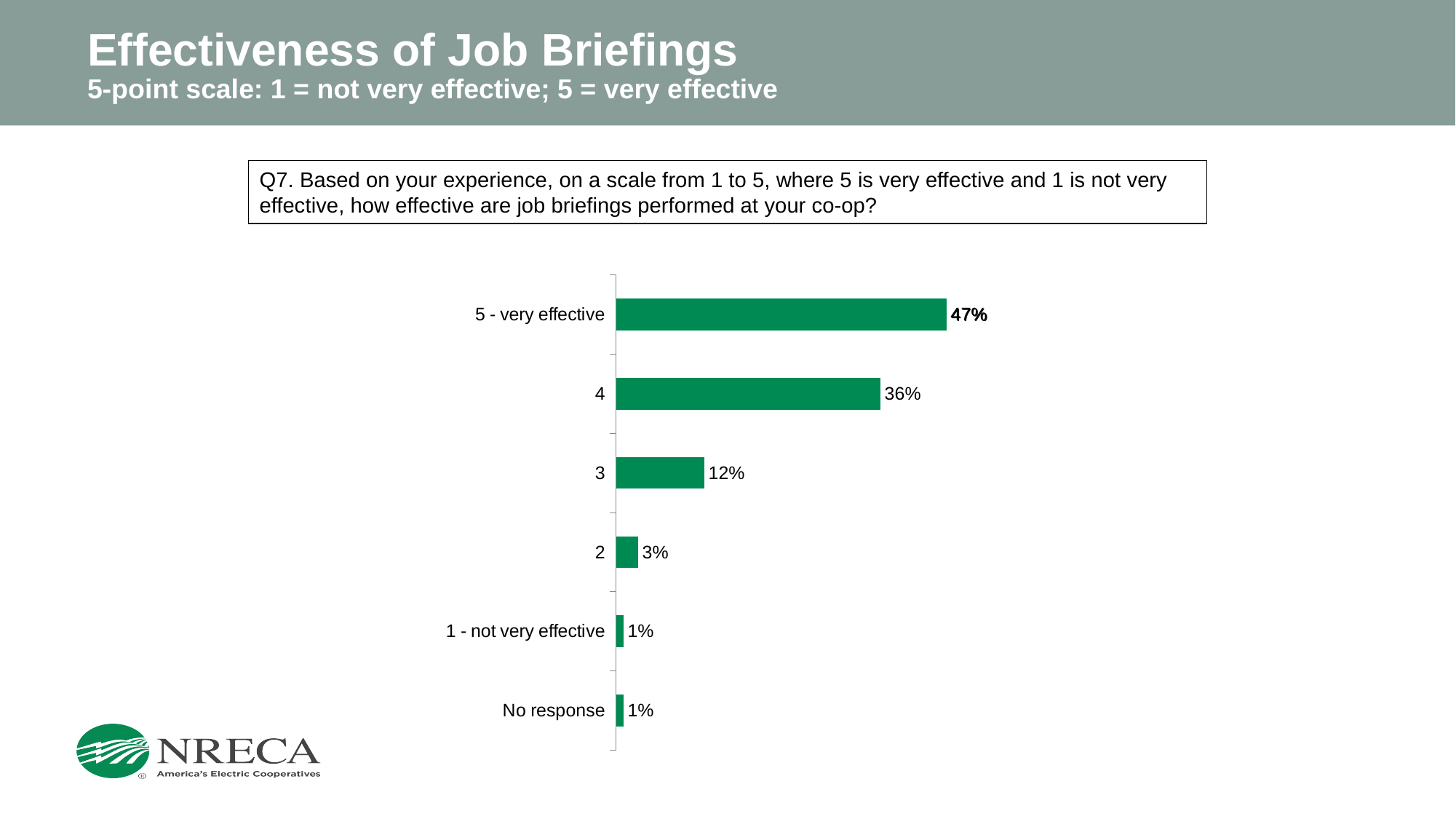
What is the title of the slide? Effectiveness of Job Briefings What is the difference in percentage points between the 5 - very effective rating and the 4 rating? 11 How many categories are shown in the chart? 6 What percentage of respondents rated job briefings as 5 - very effective? 47% Which is larger, the percentage for rating 3 or the percentage for rating 2? Rating 3 What type of chart is shown on the slide? Bar chart Which category has the highest percentage? 5 - very effective What is the difference in percentage points between the 4 rating and the 3 rating? 24 What percentage of respondents gave a rating of 3? 12% What percentage of respondents gave no response? 1% What percentage of respondents gave a rating of 4? 36% What percentage of respondents gave a rating of 2? 3%